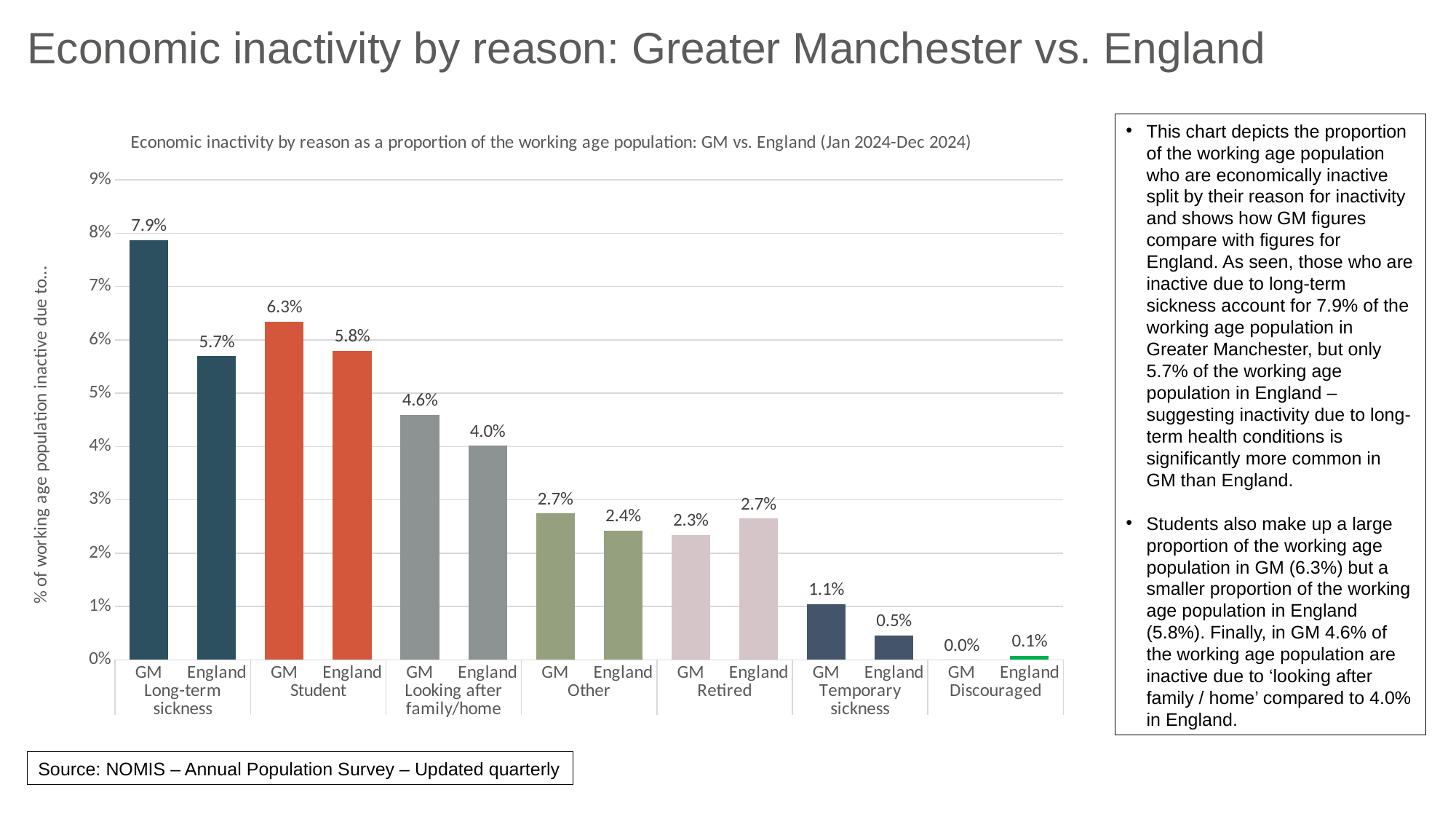
What is the value for England under Student? 5.8% Which bar has the lowest value in the chart? GM Discouraged (0.0%) How many reason categories are shown on the x axis? 7 What is the value for GM under Looking after family/home? 4.6% Under Retired, which is larger: the GM value or the England value? England Which bar has the highest value in the chart? GM Long-term sickness (7.9%) What is the source cited for the chart data? NOMIS – Annual Population Survey – Updated quarterly What is the value for GM under Long-term sickness? 7.9% What is the difference between the GM and England values for Long-term sickness? 2.2 percentage points What kind of chart is shown on the slide? Bar chart What is the value for England under Temporary sickness? 0.5% Do the GM values generally rise or fall moving from left to right across the reason categories? Fall